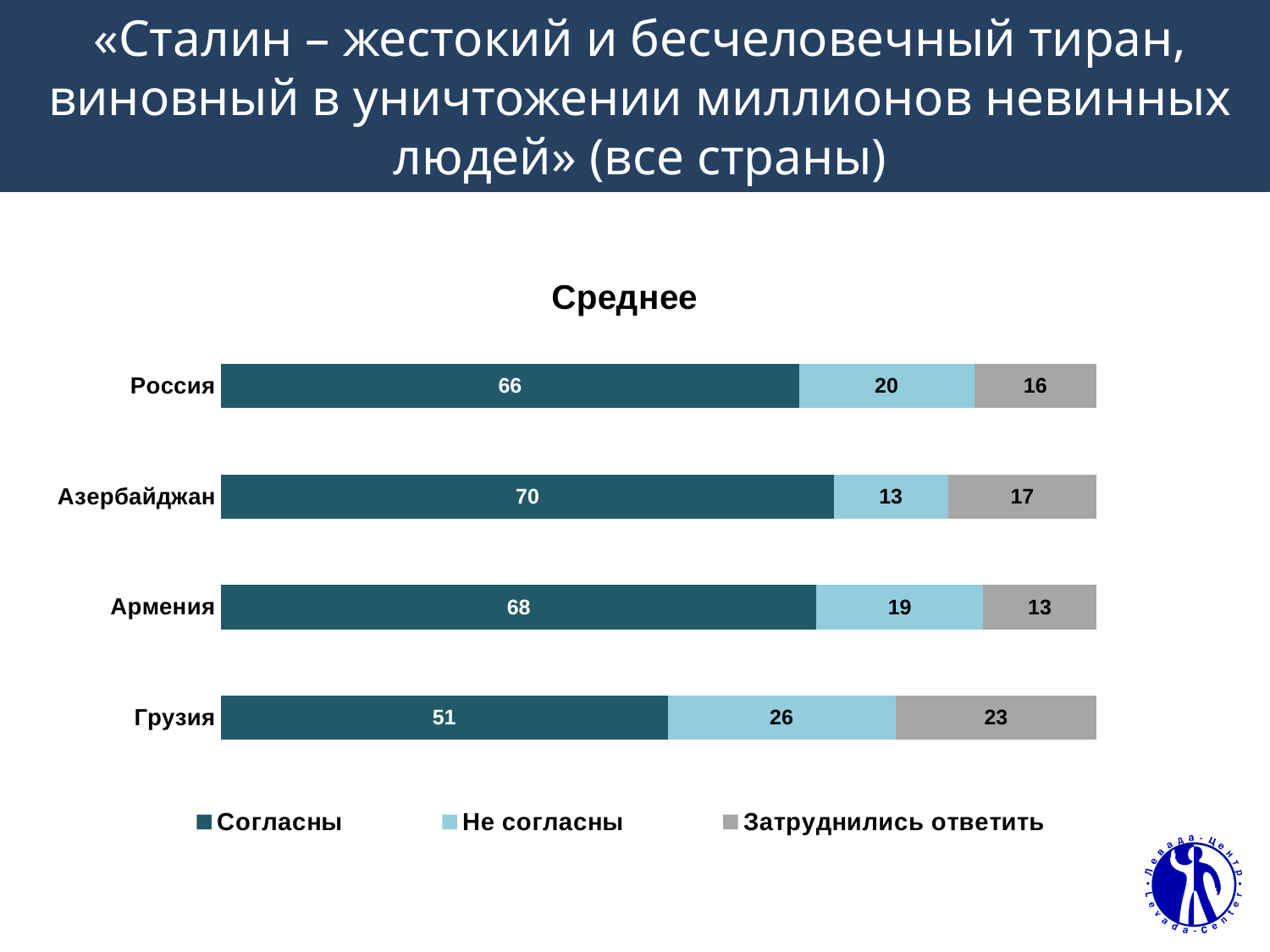
Which country has the lowest value for "Согласны"? Грузия What is the value for "Согласны" for Россия? 66 What is the value for "Не согласны" for Грузия? 26 What is the value for "Затруднились ответить" for Азербайджан? 17 How many countries are shown on the chart? 4 What kind of chart is shown on the slide? Stacked bar chart Which is larger: the "Не согласны" value for Армения or for Азербайджан? Армения What is the total of the stacked bar for Армения? 100 What is the title of the chart? Среднее How many series does the legend list? 3 Which country has the highest value for "Согласны"? Азербайджан What is the difference between the "Согласны" values for Азербайджан and Грузия? 19